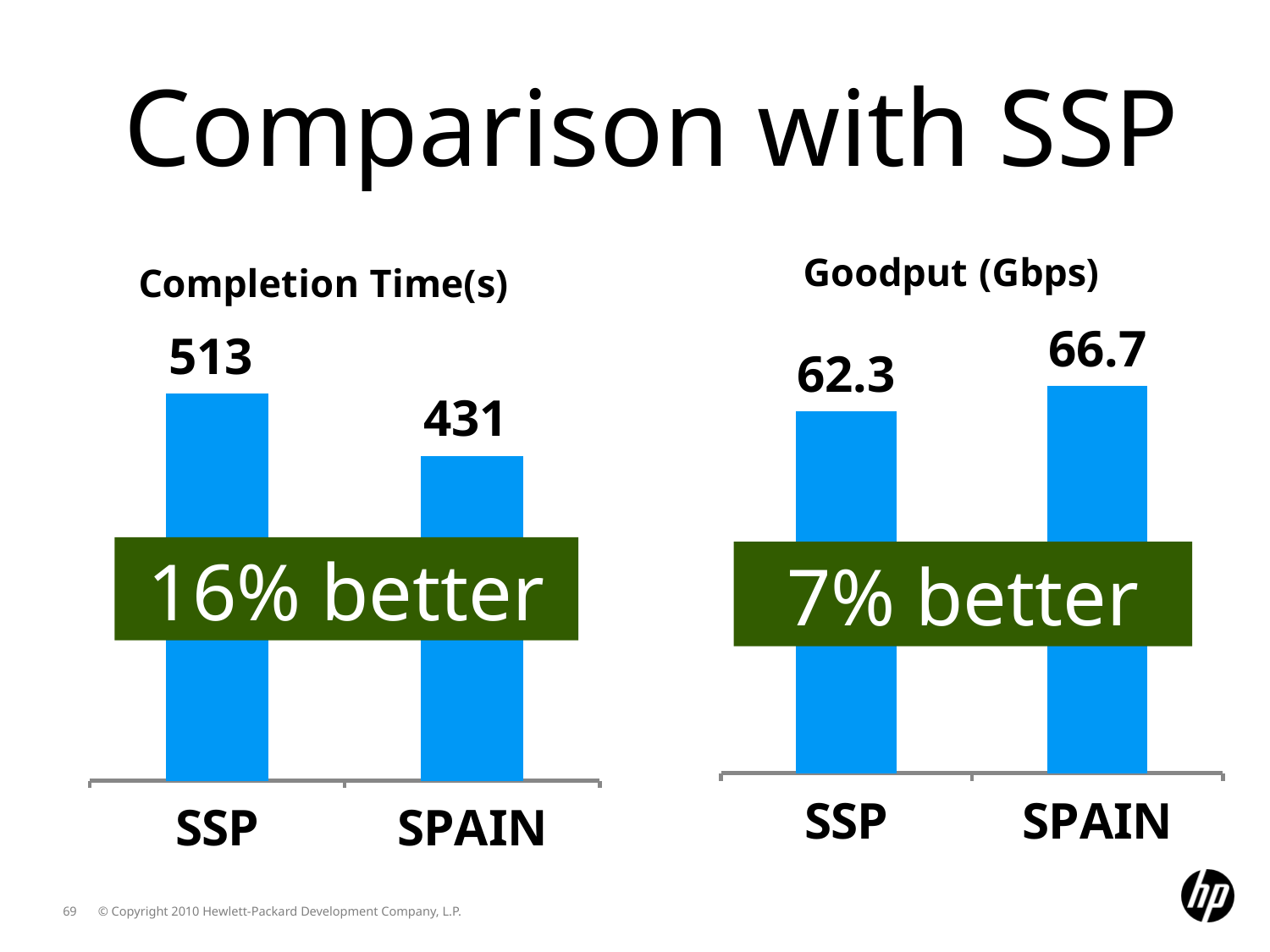
What kind of chart is the Goodput (Gbps) chart? bar chart In the Goodput (Gbps) chart, what is the value for SSP? 62.3 In the Completion Time(s) chart, which category has the highest value? SSP In the Goodput (Gbps) chart, what is the difference between the SPAIN and SSP values? 4.4 In the Completion Time(s) chart, what is the value for SSP? 513 In the Goodput (Gbps) chart, which category has the lowest value? SSP What text is shown in the green box overlaid on the Completion Time(s) chart? 16% better In the Goodput (Gbps) chart, what is the value for SPAIN? 66.7 How many categories does the Completion Time(s) chart show? 2 In the Completion Time(s) chart, what is the value for SPAIN? 431 In the Completion Time(s) chart, what is the difference between the SSP and SPAIN values? 82 In the Goodput (Gbps) chart, which is larger, SSP or SPAIN? SPAIN